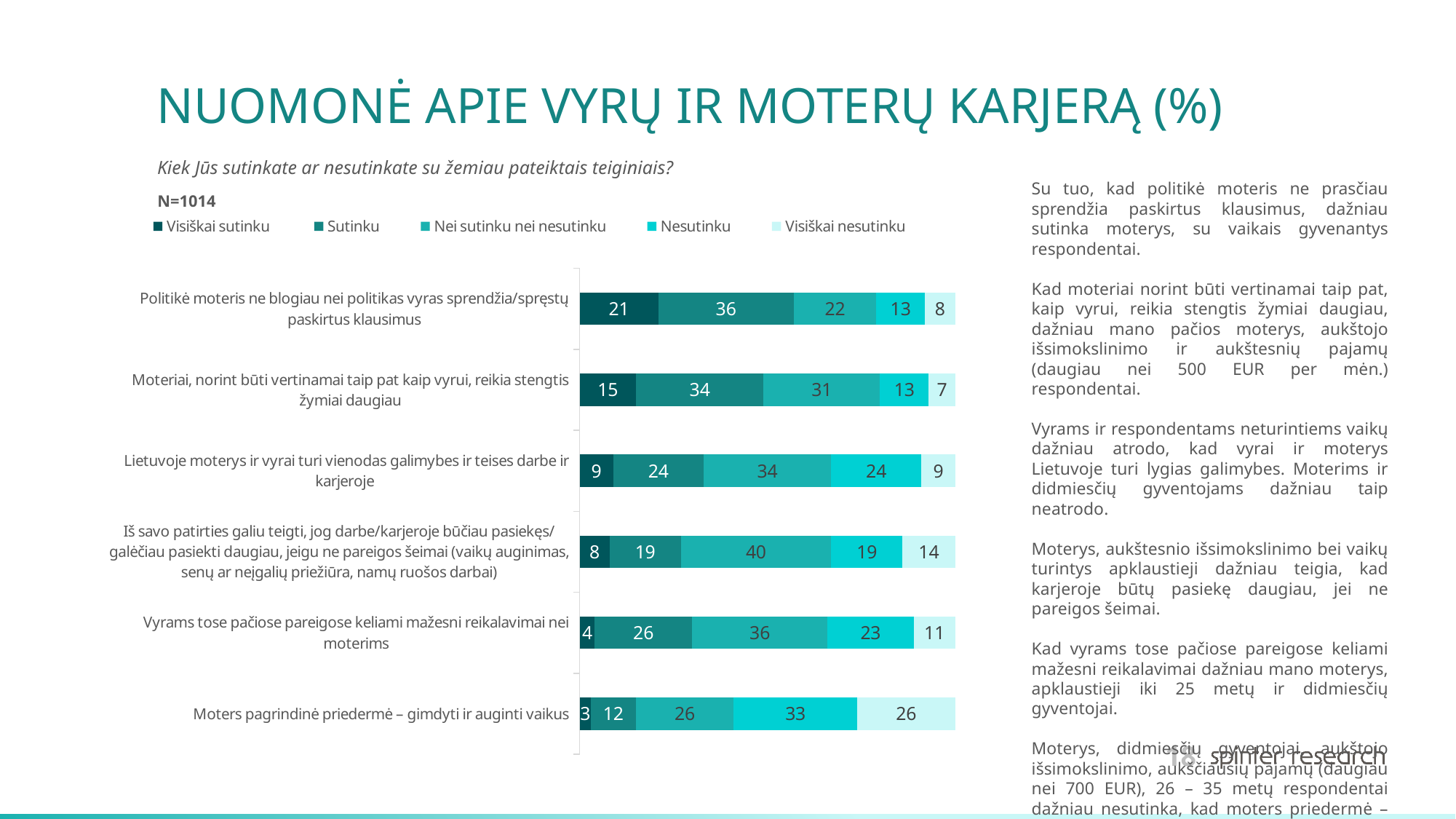
Which statement has the highest 'Visiškai sutinku' value? Politikė moteris ne blogiau nei politikas vyras sprendžia/spręstų paskirtus klausimus How many series does the legend list? 5 What is the 'Nei sutinku nei nesutinku' value for the statement 'Iš savo patirties galiu teigti, jog darbe/karjeroje būčiau pasiekęs/galėčiau pasiekti daugiau, jeigu ne pareigos šeimai'? 40 What sample size (N) is stated on the slide? N=1014 What kind of chart is shown on the slide? Stacked bar chart What is the 'Visiškai sutinku' value for the statement 'Politikė moteris ne blogiau nei politikas vyras sprendžia/spręstų paskirtus klausimus'? 21 Which statement has the lowest 'Visiškai sutinku' value? Moters pagrindinė priedermė – gimdyti ir auginti vaikus How many statements (categories) are plotted in the chart? 6 Which is larger: the 'Nesutinku' value for 'Lietuvoje moterys ir vyrai turi vienodas galimybes ir teises darbe ir karjeroje' or for 'Vyrams tose pačiose pareigose keliami mažesni reikalavimai nei moterims'? Lietuvoje moterys ir vyrai turi vienodas galimybes ir teises darbe ir karjeroje What is the total of the stacked bar for 'Moteriai, norint būti vertinamai taip pat kaip vyrui, reikia stengtis žymiai daugiau'? 100 What is the difference between the 'Sutinku' values for 'Politikė moteris ne blogiau nei politikas vyras sprendžia/spręstų paskirtus klausimus' and 'Moters pagrindinė priedermė – gimdyti ir auginti vaikus'? 24 What is the 'Visiškai nesutinku' value for the statement 'Moters pagrindinė priedermė – gimdyti ir auginti vaikus'? 26